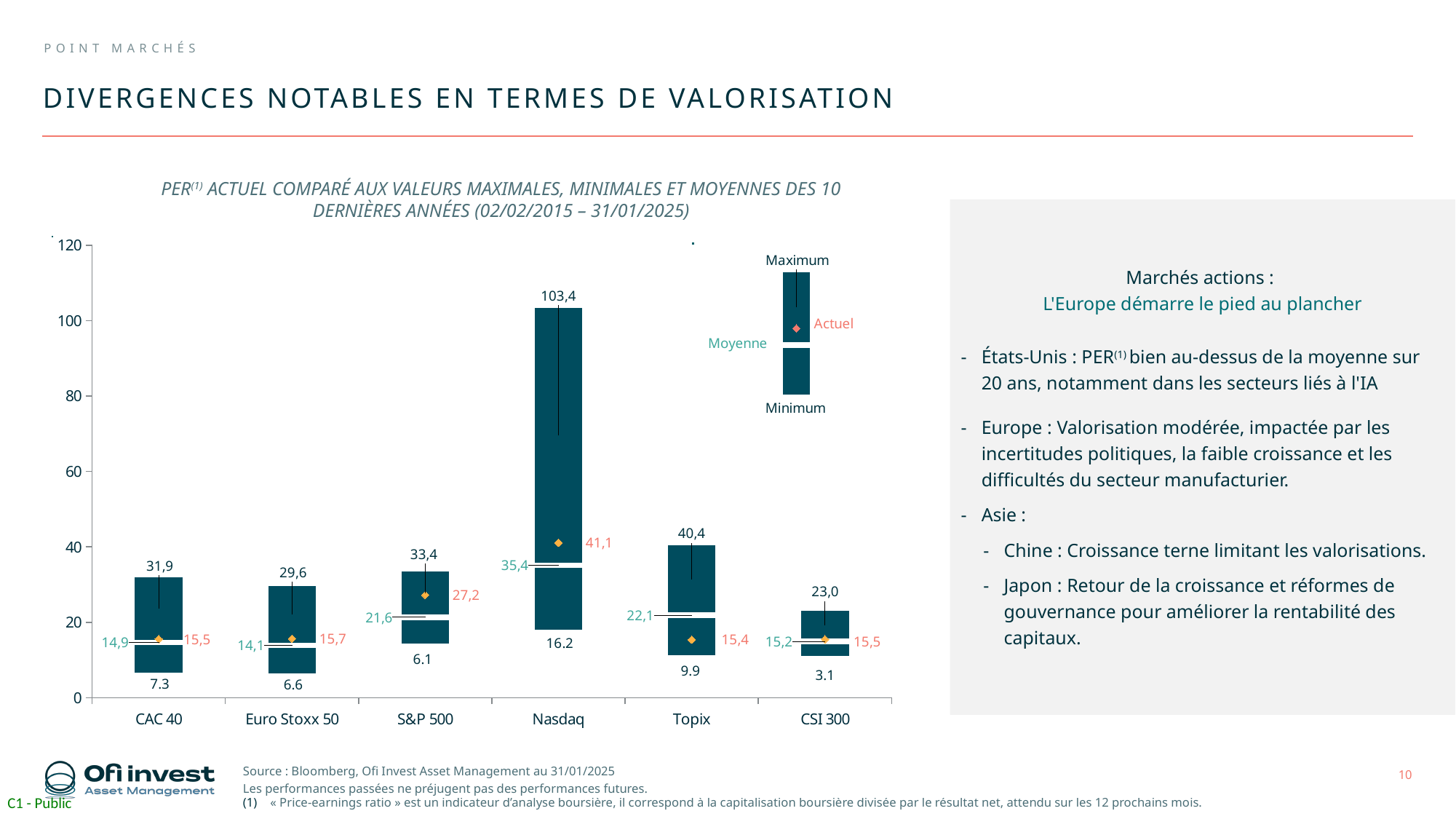
Which index has the lowest minimum PER? CSI 300 How many indices are shown on the x axis of the chart? 6 What is the difference between the maximum PER of the Topix (40,4) and the maximum PER of the CAC 40 (31,9)? 8,5 What is the current (Actuel) PER shown for the S&P 500? 27,2 Which is larger: the current PER of the Euro Stoxx 50 or the current PER of the S&P 500? S&P 500 What is the average (Moyenne) PER shown for the Topix? 22,1 What is the minimum PER shown for the CSI 300? 3.1 What colour is used for the 'Actuel' value labels on the chart? Red Is the maximum PER for the Nasdaq greater or less than 100? greater For the Topix, is the current PER (Actuel) above or below the average (Moyenne)? below Which index has the highest maximum PER? Nasdaq What is the maximum PER shown for the Nasdaq? 103,4